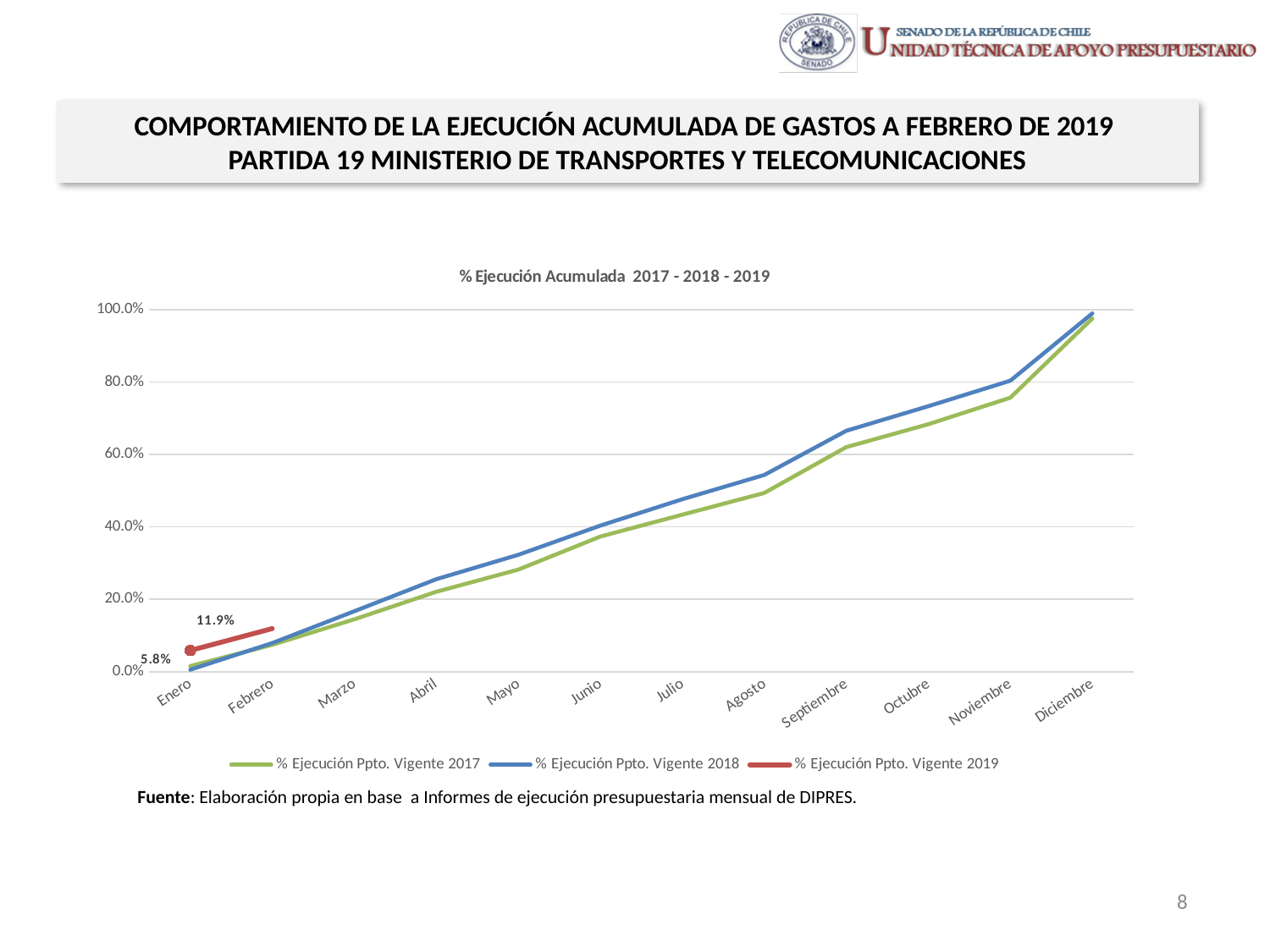
Is the value for % Ejecución Ppto. Vigente 2018 in Diciembre greater or less than 80.0%? greater How many series does the legend list? 3 By how much did % Ejecución Ppto. Vigente 2019 increase from Enero to Febrero? 6.1% What is the value of % Ejecución Ppto. Vigente 2019 for Febrero? 11.9% What kind of chart is shown on the slide? Line chart Is the value for % Ejecución Ppto. Vigente 2018 in Agosto greater or less than 40.0%? greater What is the title of the chart? % Ejecución Acumulada 2017 - 2018 - 2019 What is the value of % Ejecución Ppto. Vigente 2019 for Enero? 5.8% Is the value for % Ejecución Ppto. Vigente 2017 in Mayo greater or less than 40.0%? less Do the values for % Ejecución Ppto. Vigente 2018 rise or fall from Enero to Diciembre? Rise In Noviembre, which series has the higher value: % Ejecución Ppto. Vigente 2017 or % Ejecución Ppto. Vigente 2018? % Ejecución Ppto. Vigente 2018 How many months are shown on the x axis? 12